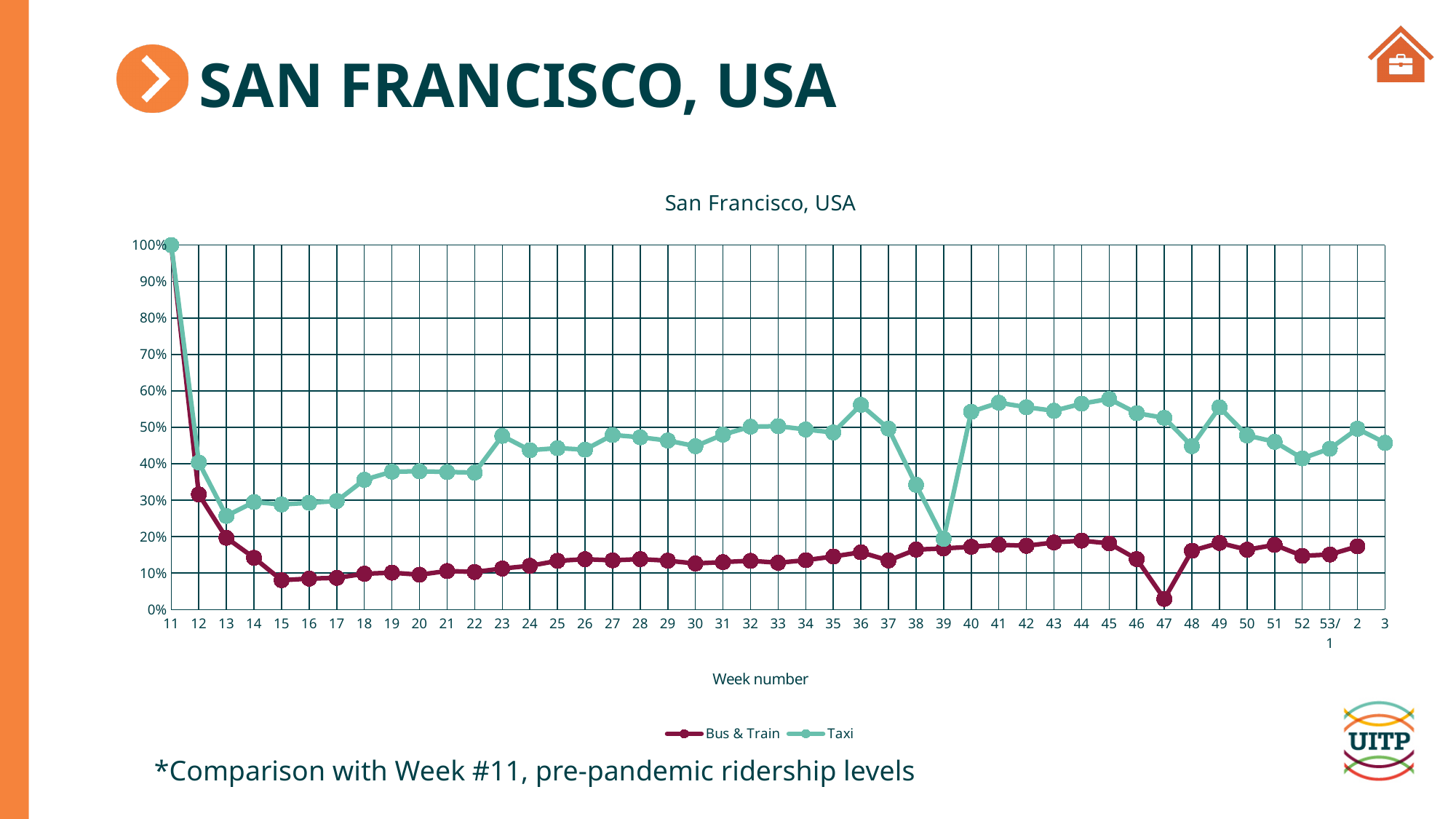
What is the Bus & Train value at week 11? 100% Is the Taxi value at week 36 greater or less than 50%? greater What is the Taxi value at week 11? 100% What kind of chart is shown on the slide? line chart Does the Taxi series rise or fall between week 13 and week 23? rise Is the Bus & Train value at week 47 greater or less than 10%? less At week 30, which series has the larger value, Taxi or Bus & Train? Taxi What is the title of the x axis? Week number Is the Taxi value at week 39 greater or less than 30%? less How many series does the legend list? 2 Apart from week 11, at which week is the Bus & Train value lowest? 47 What are the two series named in the legend? Bus & Train and Taxi